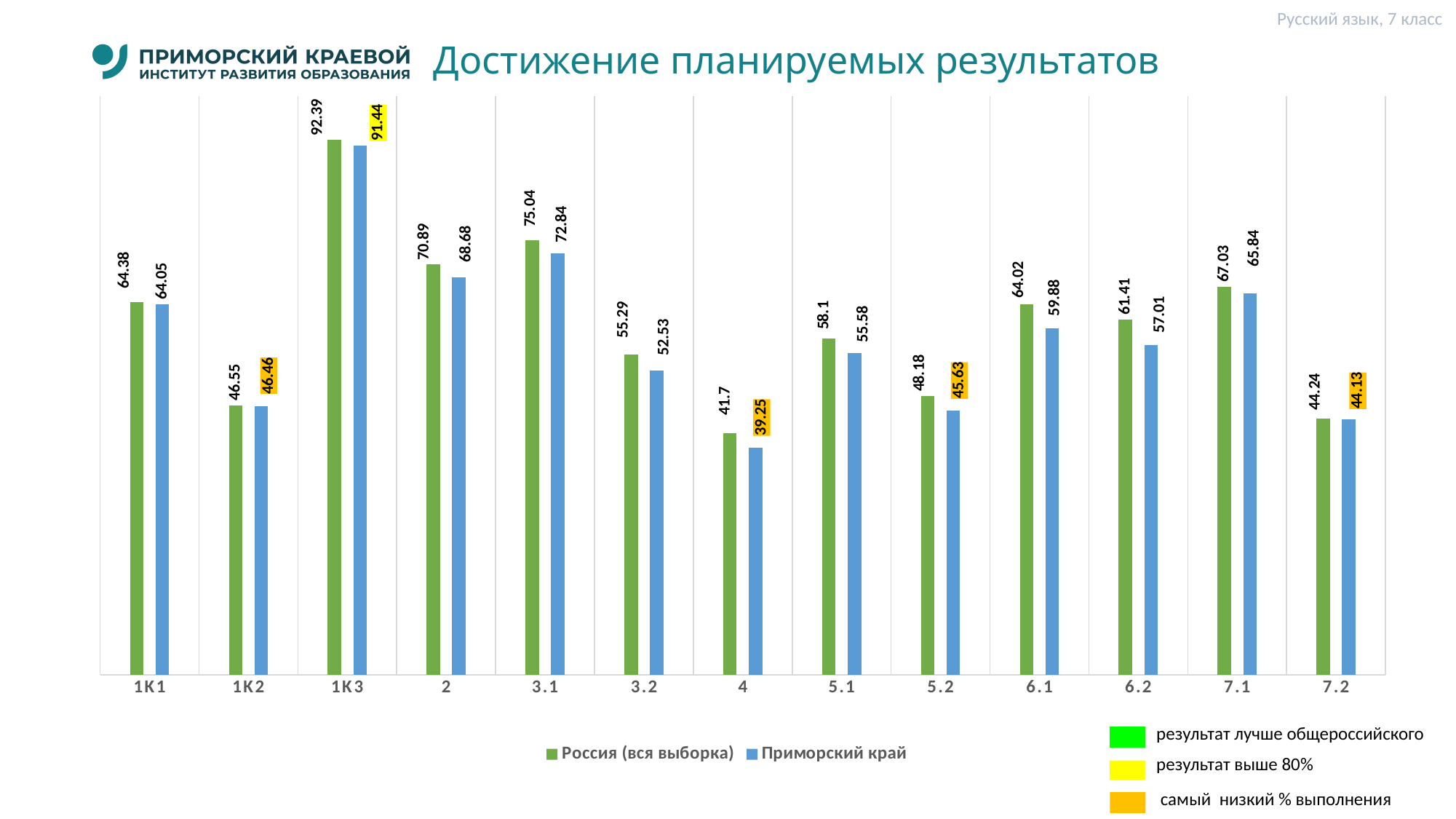
What is the value for Россия (вся выборка) for category 3.1? 75.04 What kind of chart is shown on the slide? Bar chart How many series does the legend list? 2 How many categories are shown on the x axis? 13 Which category has the highest value for Приморский край? 1К3 What is the difference between the Россия (вся выборка) and Приморский край values for category 4? 2.45 Which category has the lowest value for Россия (вся выборка)? 4 What is the value for Россия (вся выборка) for category 4? 41.7 What is the value for Приморский край for category 6.1? 59.88 Which is larger: the Приморский край value for 5.1 or for 3.2? 5.1 What is the value for Приморский край for category 1К3? 91.44 What is the difference between the Россия (вся выборка) and Приморский край values for category 6.2? 4.4